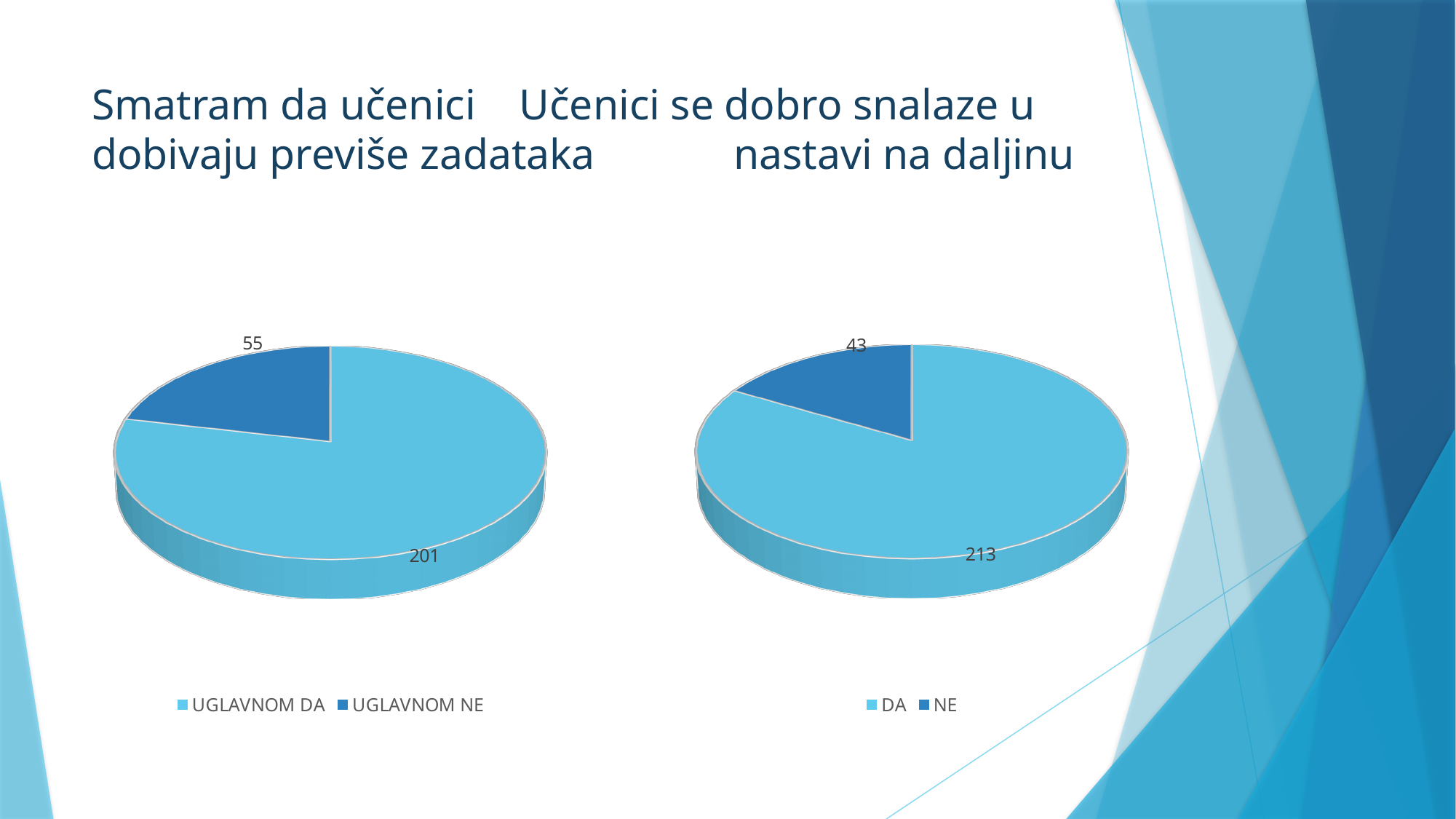
What type of chart is used on this slide? Pie chart In the left pie chart (Smatram da učenici dobivaju previše zadataka), what is the value for UGLAVNOM NE? 55 How many slices does the left pie chart have? 2 In the left pie chart, which category has the largest slice? UGLAVNOM DA Which is larger: NE in the right pie chart or UGLAVNOM NE in the left pie chart? UGLAVNOM NE in the left pie chart In the right pie chart (Učenici se dobro snalaze u nastavi na daljinu), what is the value for DA? 213 In the right pie chart (Učenici se dobro snalaze u nastavi na daljinu), what is the value for NE? 43 In the right pie chart, which category has the smallest slice? NE In the left pie chart (Smatram da učenici dobivaju previše zadataka), what is the value for UGLAVNOM DA? 201 What is the total of all slices in the right pie chart? 256 In the right pie chart, what is the difference between DA and NE? 170 In the left pie chart, what is the difference between UGLAVNOM DA and UGLAVNOM NE? 146